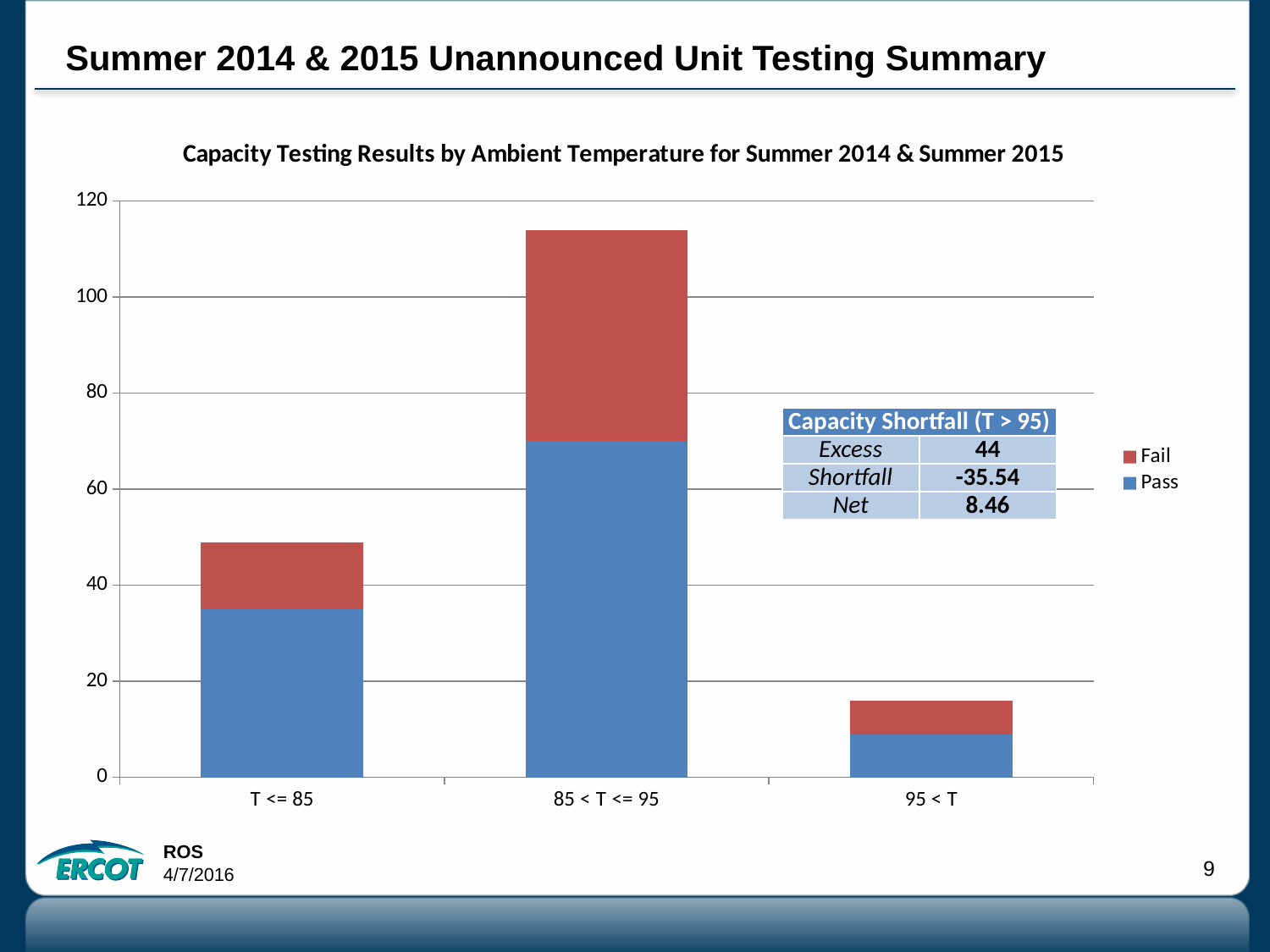
Is the total height of the bar for 95 < T greater or less than 20? less Is the Pass value for 85 < T <= 95 greater or less than 60? greater In the 85 < T <= 95 category, which is larger, the Pass segment or the Fail segment? Pass Which colour represents the Fail series in the chart? Red How many series does the chart's legend list? 2 How many temperature categories are shown on the x axis of the chart? 3 Is the total height of the bar for 85 < T <= 95 greater or less than 100? greater What kind of chart is shown on the slide? Stacked bar chart Which temperature category has the shortest stacked bar? 95 < T Which temperature category has the tallest stacked bar? 85 < T <= 95 Which has the larger total bar, T <= 85 or 95 < T? T <= 85